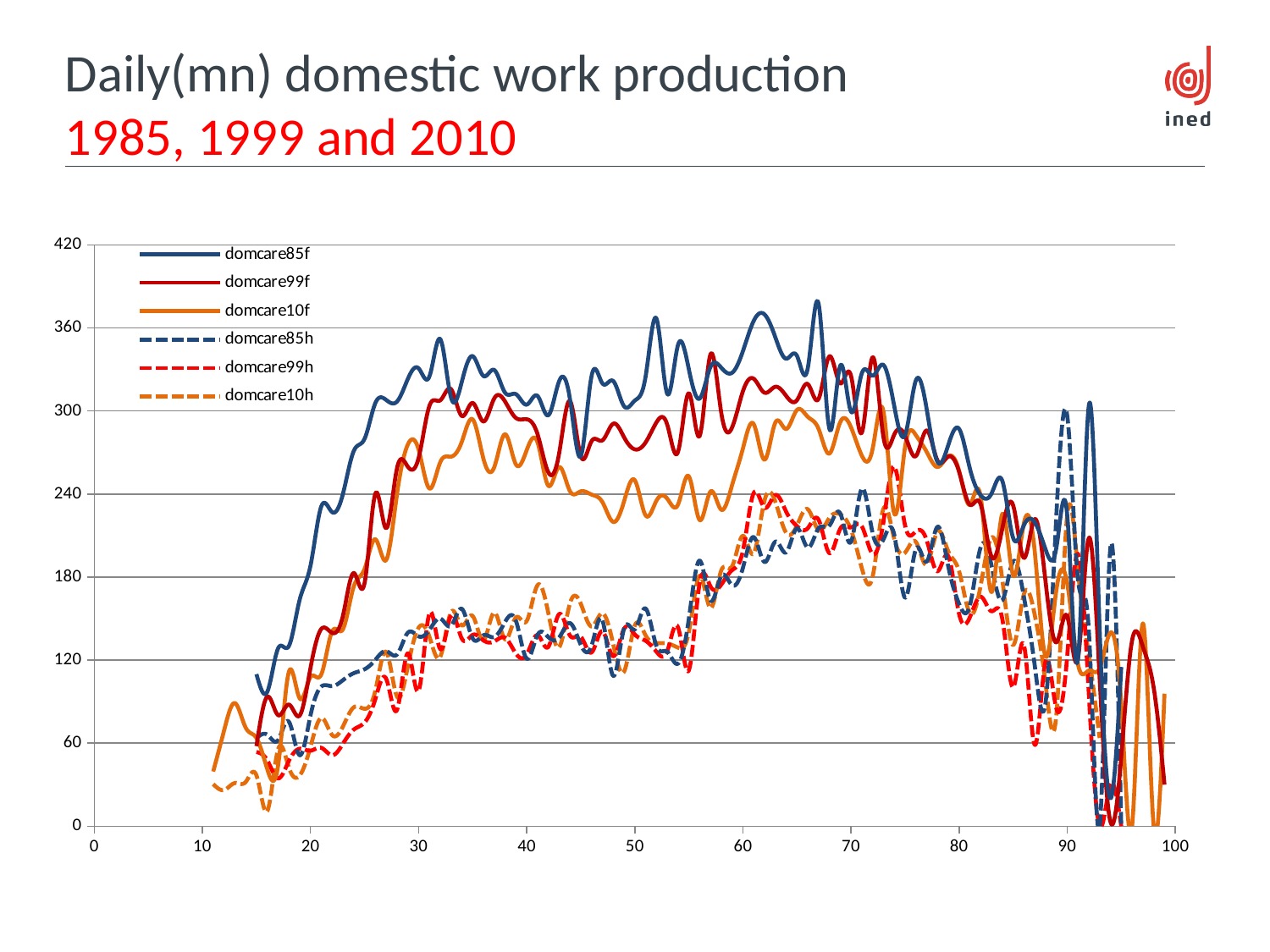
Is the value of domcare85f at x = 30 greater or less than 300? greater Is the value of domcare85h at x = 40 greater or less than 180? less What colour is the domcare85f line? dark blue At x = 30, which is larger: domcare85f or domcare85h? domcare85f Which series reaches the highest peak on the chart? domcare85f Which series are drawn with dashed lines? domcare85h, domcare99h, domcare10h Does domcare99f rise or fall between x = 80 and x = 95? fall Is the value of domcare85f at x = 60 greater or less than 300? greater How many series does the legend list? 6 Does domcare85f rise or fall between x = 15 and x = 30? rise What kind of chart is shown on the slide? line chart